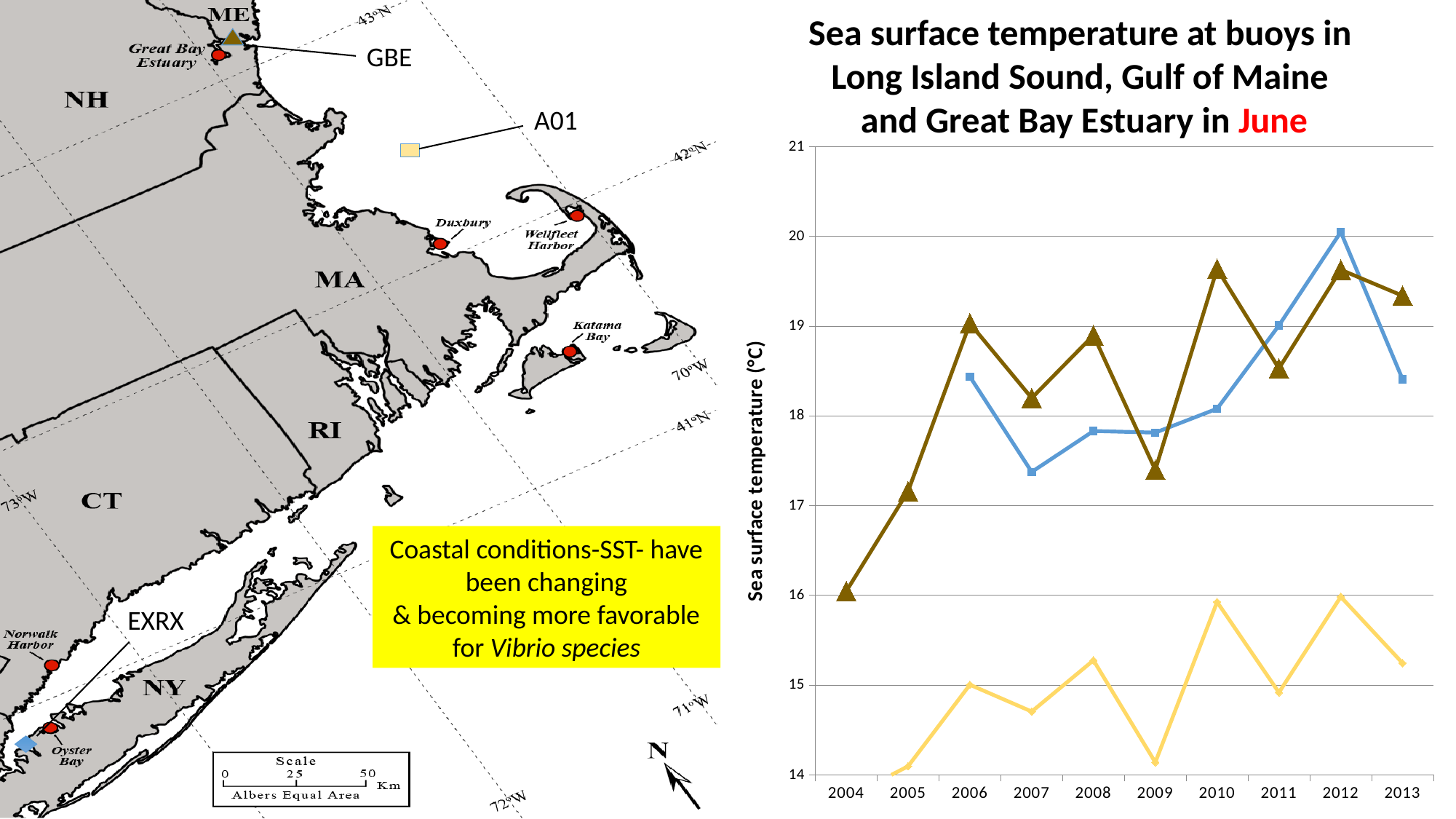
In the sea surface temperature chart, which series has the higher value in 2012, the blue square series or the brown triangle series? blue square series In the sea surface temperature chart, is the value of the blue square series in 2012 greater or less than 19? greater In the sea surface temperature chart, is the value of the brown triangle series in 2004 greater or less than 17? less In the sea surface temperature chart, in which year does the blue square series reach its highest value? 2012 In the sea surface temperature chart, is the value of the yellow line in 2009 greater or less than 15? less In the sea surface temperature chart, which series has the higher value in 2006, the brown triangle series or the blue square series? brown triangle series What is the label on the y axis of the sea surface temperature chart? Sea surface temperature (°C) How many years are shown along the x axis of the sea surface temperature chart? 10 What kind of chart is shown on the right side of the slide? line chart In the sea surface temperature chart, in which year does the brown triangle series have its lowest value? 2004 In the sea surface temperature chart, does the brown triangle series rise or fall from 2004 to 2006? rise